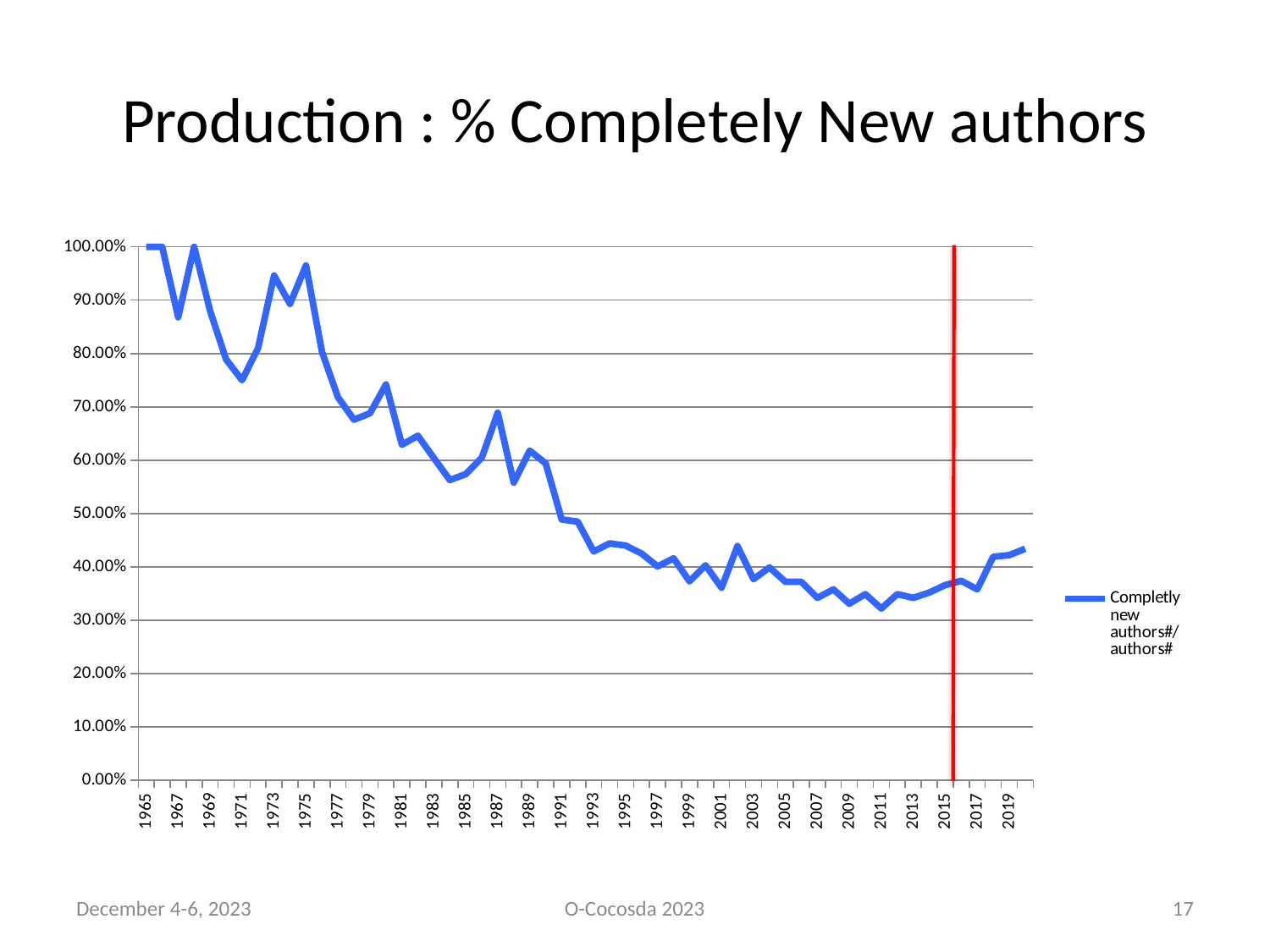
What kind of chart is shown on the slide? line chart What is the legend entry for the plotted series? Completly new authors#/authors# Which is larger, the value for 1975 or the value for 1995? 1975 Is the value for 1971 greater or less than 70.00%? greater What is the highest value reached by the line? 100.00% Overall, do the values rise or fall from 1965 to 2015? fall What is the title of the chart on the slide? Production : % Completely New authors Is the value for 2019 greater or less than 40.00%? greater Is the value for 1993 greater or less than 50.00%? less What is the value for 1965? 100.00% How many series does the legend list? 1